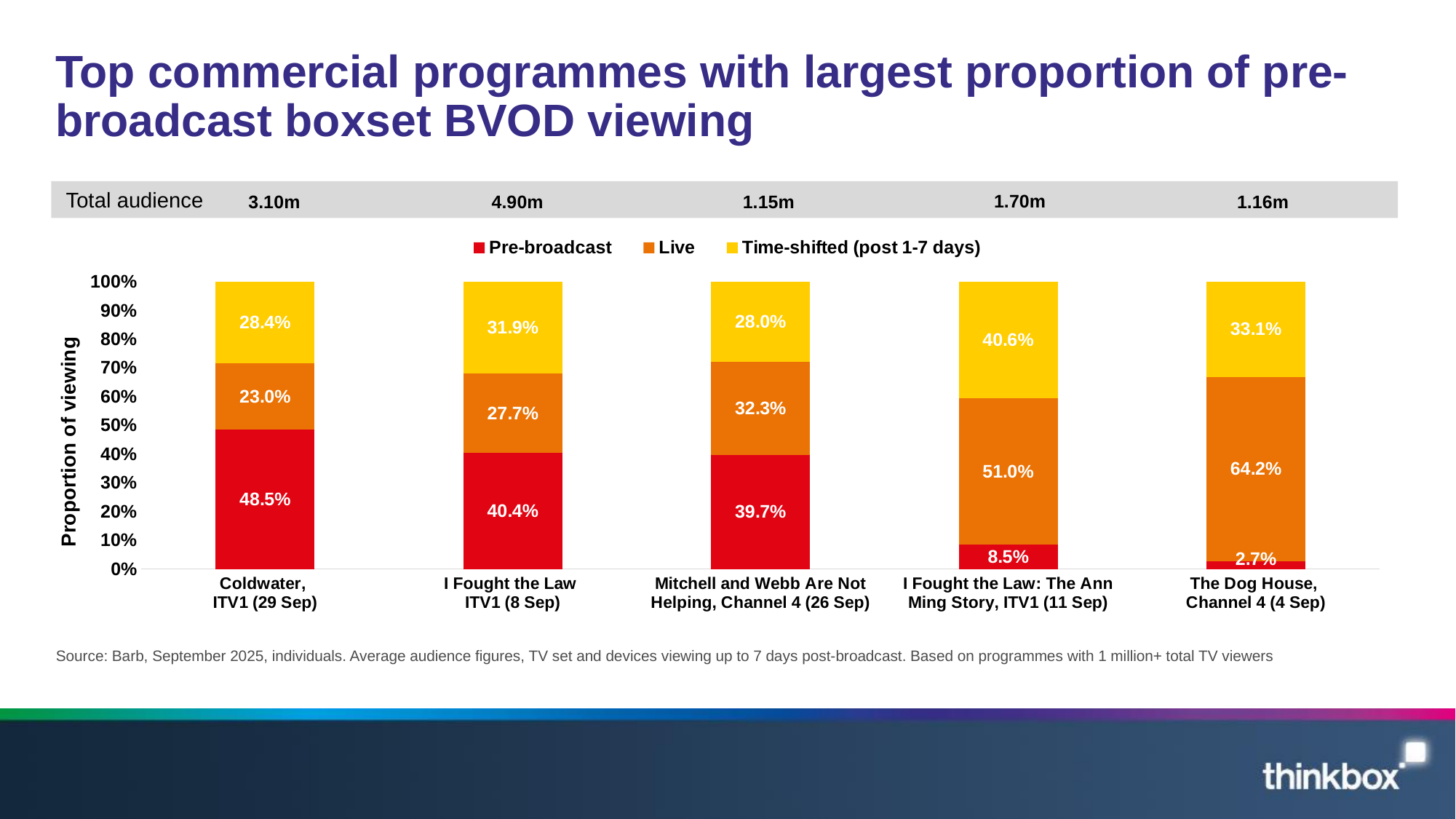
Which programme has the highest Pre-broadcast share? Coldwater, ITV1 (29 Sep) What is the difference between the Live share for Mitchell and Webb Are Not Helping, Channel 4 (26 Sep) and the Live share for Coldwater, ITV1 (29 Sep)? 9.3% Which colour represents Live in the chart? Orange What is the Time-shifted (post 1-7 days) share for I Fought the Law: The Ann Ming Story, ITV1 (11 Sep)? 40.6% Which is larger: the Time-shifted share for I Fought the Law ITV1 (8 Sep) or the Time-shifted share for The Dog House, Channel 4 (4 Sep)? The Dog House, Channel 4 (4 Sep) What is the Pre-broadcast share for Coldwater, ITV1 (29 Sep)? 48.5% Which programme has the lowest Pre-broadcast share? The Dog House, Channel 4 (4 Sep) How many programmes are shown on the chart? 5 What kind of chart is shown on the slide? Stacked bar chart How many series does the legend list? 3 What is the Live share for The Dog House, Channel 4 (4 Sep)? 64.2% What is the total audience shown for I Fought the Law ITV1 (8 Sep)? 4.90m